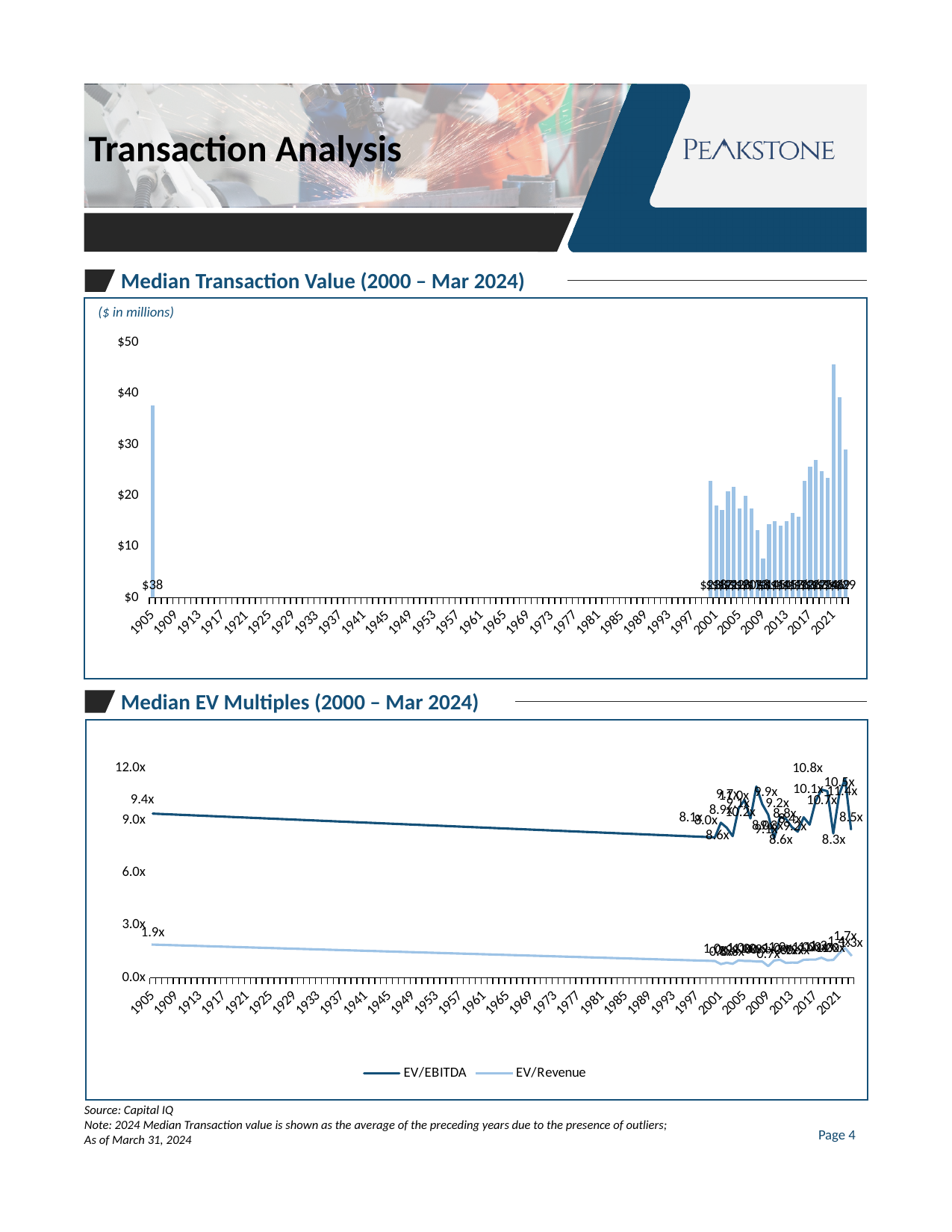
In the Median EV Multiples chart, is the EV/Revenue value at 1905 greater or less than 3.0x? less In the Median EV Multiples chart, what is the difference between the EV/EBITDA value (9.4x) and the EV/Revenue value (1.9x) at the first point? 7.5x In the Median EV Multiples chart, what is the EV/Revenue value labeled at the first point (1905)? 1.9x What kind of chart is the Median Transaction Value (2000 – Mar 2024) chart? bar chart In the Median Transaction Value chart, what is the labeled value of the first bar at 1905? $38 In the Median EV Multiples chart, what is the EV/EBITDA value labeled at the first point (1905)? 9.4x What kind of chart is the Median EV Multiples (2000 – Mar 2024) chart? line chart In the Median EV Multiples chart, which series has the larger value at the first point (1905), EV/EBITDA or EV/Revenue? EV/EBITDA How many series does the legend of the Median EV Multiples chart list? 2 In the Median Transaction Value chart, is the tallest bar greater or less than $40? greater In what units are the values of the Median Transaction Value chart shown? $ in millions What are the two series named in the legend of the Median EV Multiples chart? EV/EBITDA and EV/Revenue